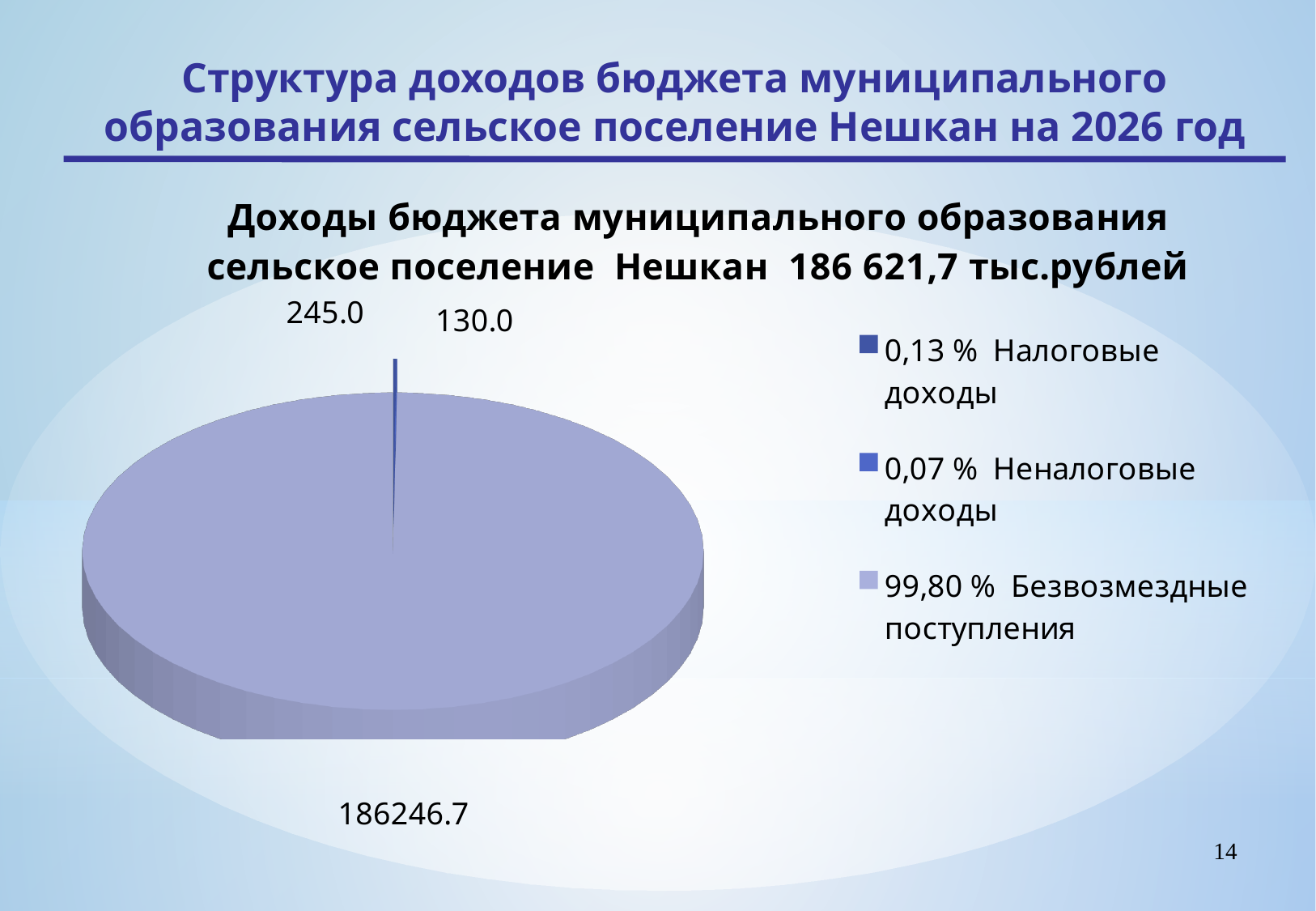
What share of the pie does Безвозмездные поступления represent, according to the legend? 99,80 % What is the value shown for Безвозмездные поступления? 186246.7 Which category has the smallest value? Неналоговые доходы What total amount in тыс.рублей is stated in the chart title? 186 621,7 тыс.рублей Which category has the largest slice of the pie? Безвозмездные поступления What is the difference between the values for Налоговые доходы and Неналоговые доходы? 115.0 Which is larger, the value for Налоговые доходы or Неналоговые доходы? Налоговые доходы What is the value shown for Неналоговые доходы? 130.0 What kind of chart is shown on the slide? pie chart What is the value shown for Налоговые доходы? 245.0 What share of the pie does Налоговые доходы represent, according to the legend? 0,13 % How many slices does the pie chart have? 3